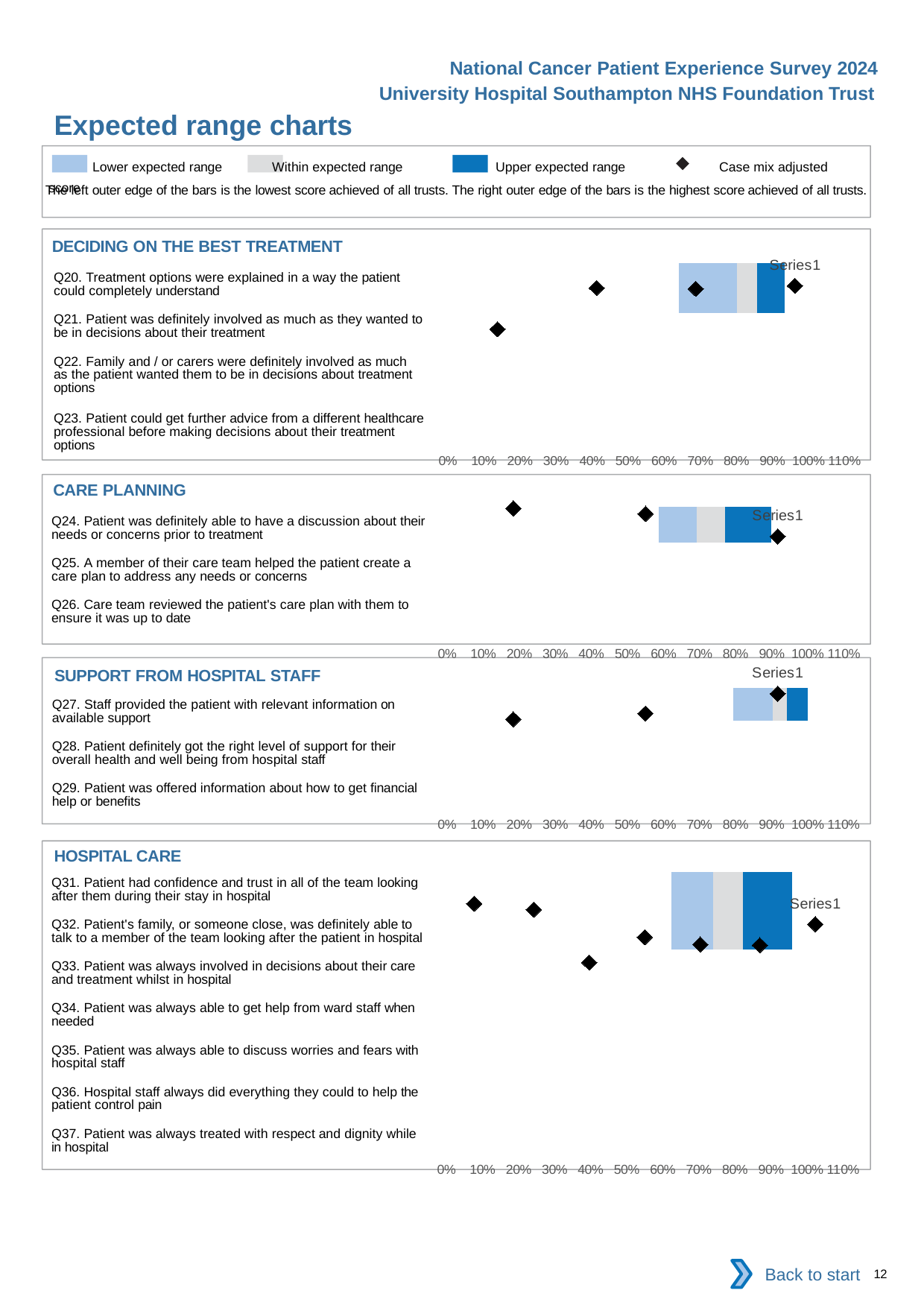
How many questions are listed in the 'HOSPITAL CARE' chart? 7 According to the legend, what does the dark blue colour represent? Upper expected range How many questions are listed in the 'SUPPORT FROM HOSPITAL STAFF' chart? 3 In the 'CARE PLANNING' chart, is the right edge of the shaded bar greater or less than 80%? greater In the 'DECIDING ON THE BEST TREATMENT' chart, is the left edge of the shaded bar greater or less than 50%? greater Which section on the slide lists the most questions? HOSPITAL CARE What is the highest tick label shown on the x axis of the 'HOSPITAL CARE' chart? 110% How many questions are listed in the 'CARE PLANNING' chart? 3 How many entries does the legend at the top of the slide list? 4 In the 'HOSPITAL CARE' chart, is the left edge of the shaded bar greater or less than 50%? greater What kind of chart is used in the 'DECIDING ON THE BEST TREATMENT' section? bar chart